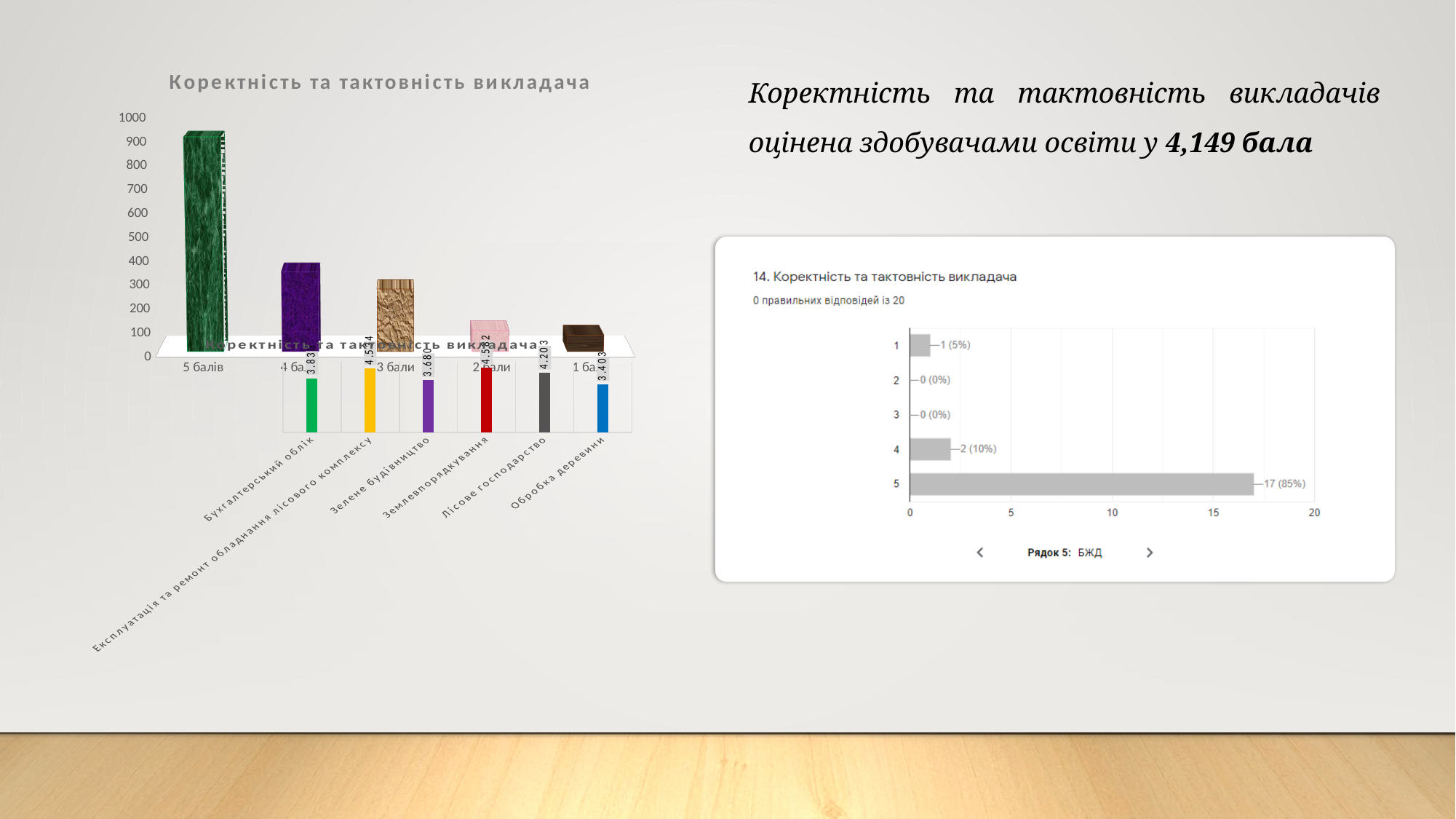
In the 3D bar chart titled 'Коректність та тактовність викладача' at the top left, which category has the highest bar? 5 балів In the 3D bar chart at the top left, is the value for '2 бали' greater or less than 200? less In the small bar chart with specialty names below the 3D chart, what is the value for 'Обробка деревини'? 3.403 In the small bar chart with specialty names below the 3D chart, what is the value for 'Зелене будівництво'? 3.680 In the 3D bar chart at the top left, is the value for '4 бали' greater or less than 500? less In the chart on the right titled '14. Коректність та тактовність викладача', what is the value for category 5? 17 (85%) In the small bar chart with specialty names below the 3D chart, what is the value for 'Лісове господарство'? 4.203 In the chart on the right titled '14. Коректність та тактовність викладача', what is the value for category 4? 2 (10%) In the 3D bar chart at the top left, which is larger, the value for '4 бали' or the value for '1 бал'? 4 бали In the 3D bar chart at the top left, is the value for '5 балів' greater or less than 800? greater In the 3D bar chart at the top left, how many categories are shown on the x axis? 5 In the chart on the right titled '14. Коректність та тактовність викладача', what is the difference between the values for category 5 and category 1? 16